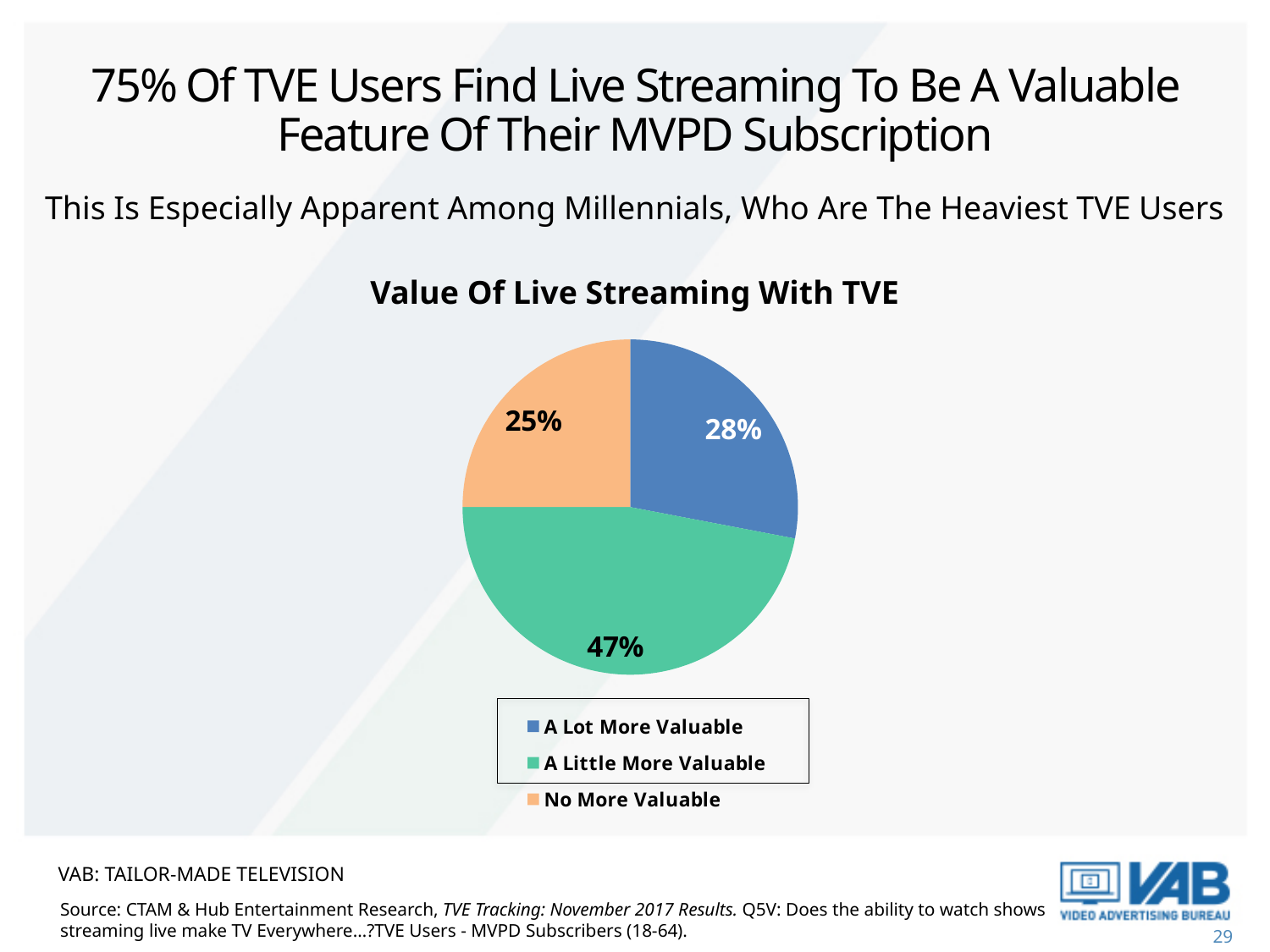
Which is larger, the share for "A Lot More Valuable" or the share for "No More Valuable"? A Lot More Valuable What is the combined share of "A Lot More Valuable" and "A Little More Valuable"? 75% What percentage of TVE users said live streaming is "A Little More Valuable"? 47% What percentage of TVE users said live streaming is "No More Valuable"? 25% Which category has the largest share of the pie? A Little More Valuable What percentage of TVE users said live streaming is "A Lot More Valuable"? 28% What is the title of the chart? Value Of Live Streaming With TVE What type of chart is shown on the slide? Pie chart What colour represents "No More Valuable" in the pie chart? Orange How many categories does the legend list? 3 Which category has the smallest share of the pie? No More Valuable What is the difference in percentage points between "A Little More Valuable" and "A Lot More Valuable"? 19